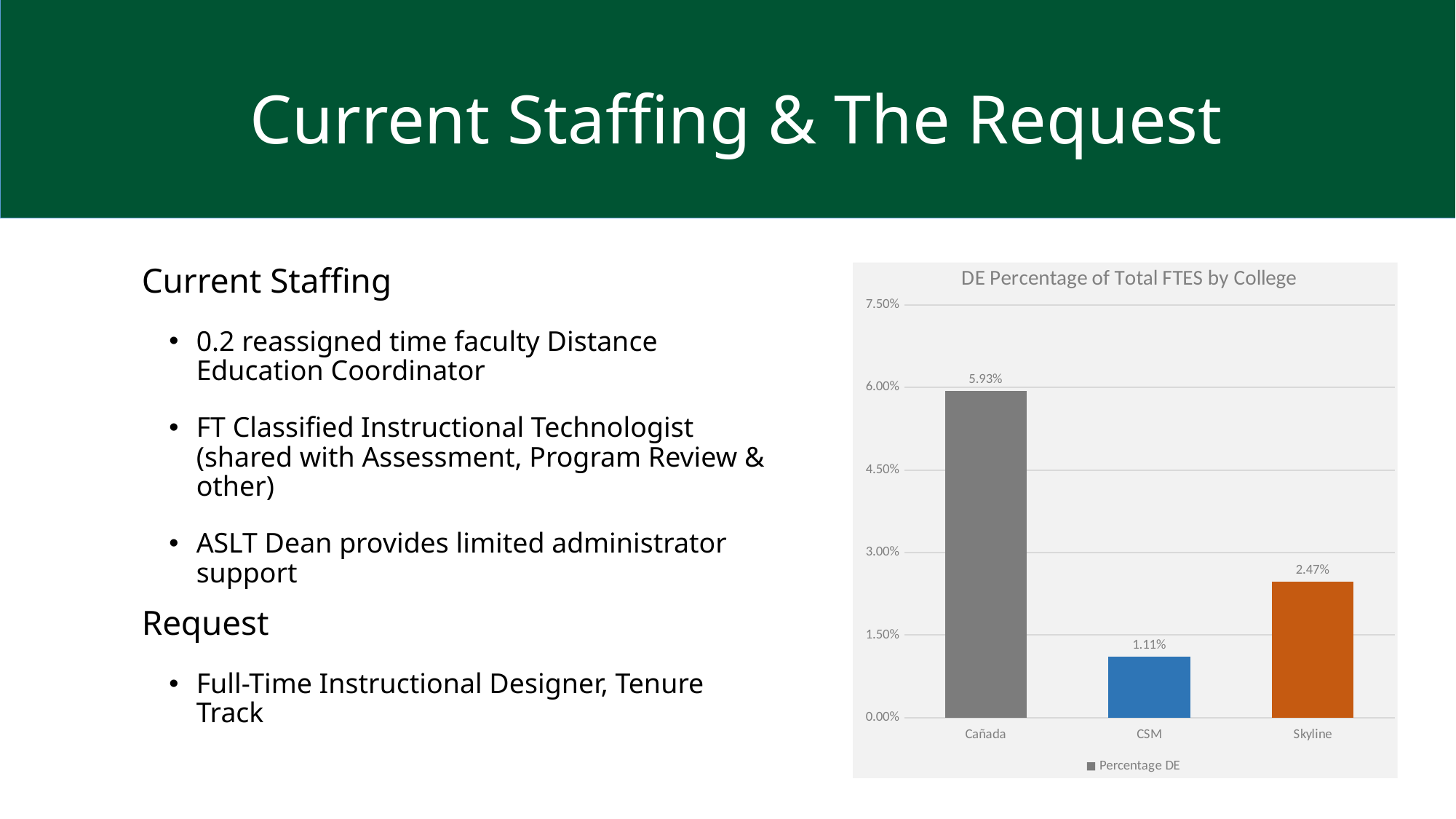
Is the value for Cañada greater or less than 4.50%? greater What is the difference between the DE percentage for Cañada and Skyline? 3.46% How many colleges are shown in the chart? 3 What is the DE percentage of total FTES for Skyline? 2.47% What is the DE percentage of total FTES for Cañada? 5.93% What type of chart is shown on the slide? Bar chart Which has a larger DE percentage of total FTES, Skyline or CSM? Skyline Which college has the highest DE percentage of total FTES? Cañada What is the difference between the DE percentage for Skyline and CSM? 1.36% What is the title of the chart? DE Percentage of Total FTES by College Which college has the lowest DE percentage of total FTES? CSM What is the DE percentage of total FTES for CSM? 1.11%